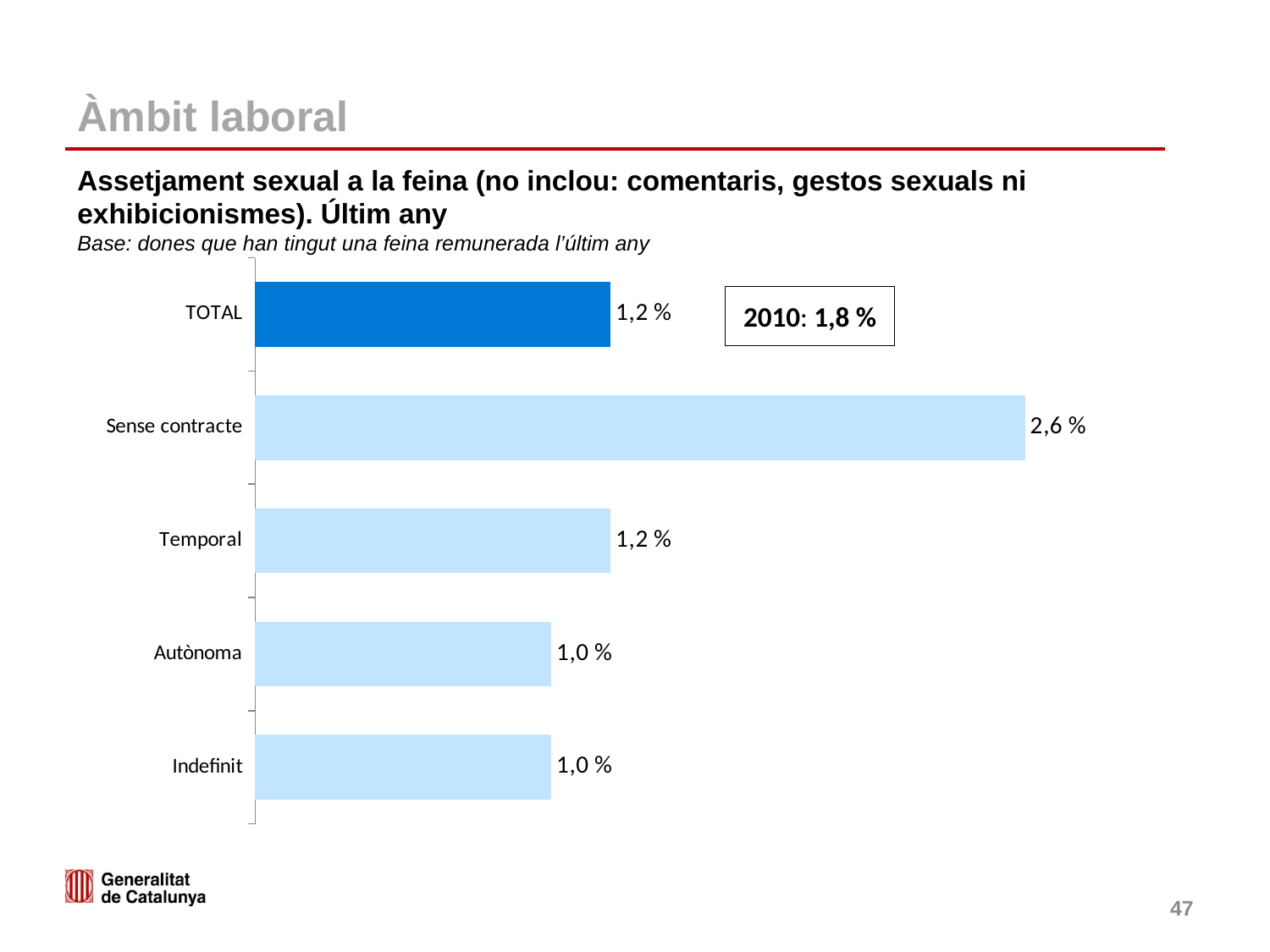
Which is larger, the value for Temporal or the value for Autònoma? Temporal Which bar is drawn in a darker blue than the others? TOTAL How many categories are shown in the chart? 5 What is the value for Sense contracte? 2,6 % What is the value for TOTAL? 1,2 % What was the TOTAL value in 2010, according to the box on the chart? 1,8 % What is the value for Autònoma? 1,0 % What kind of chart is shown on the slide? Bar chart What is the difference between the values for Sense contracte and Temporal? 1,4 % What is the value for Indefinit? 1,0 % Which category has the highest value? Sense contracte What is the difference between the values for Sense contracte and TOTAL? 1,4 %